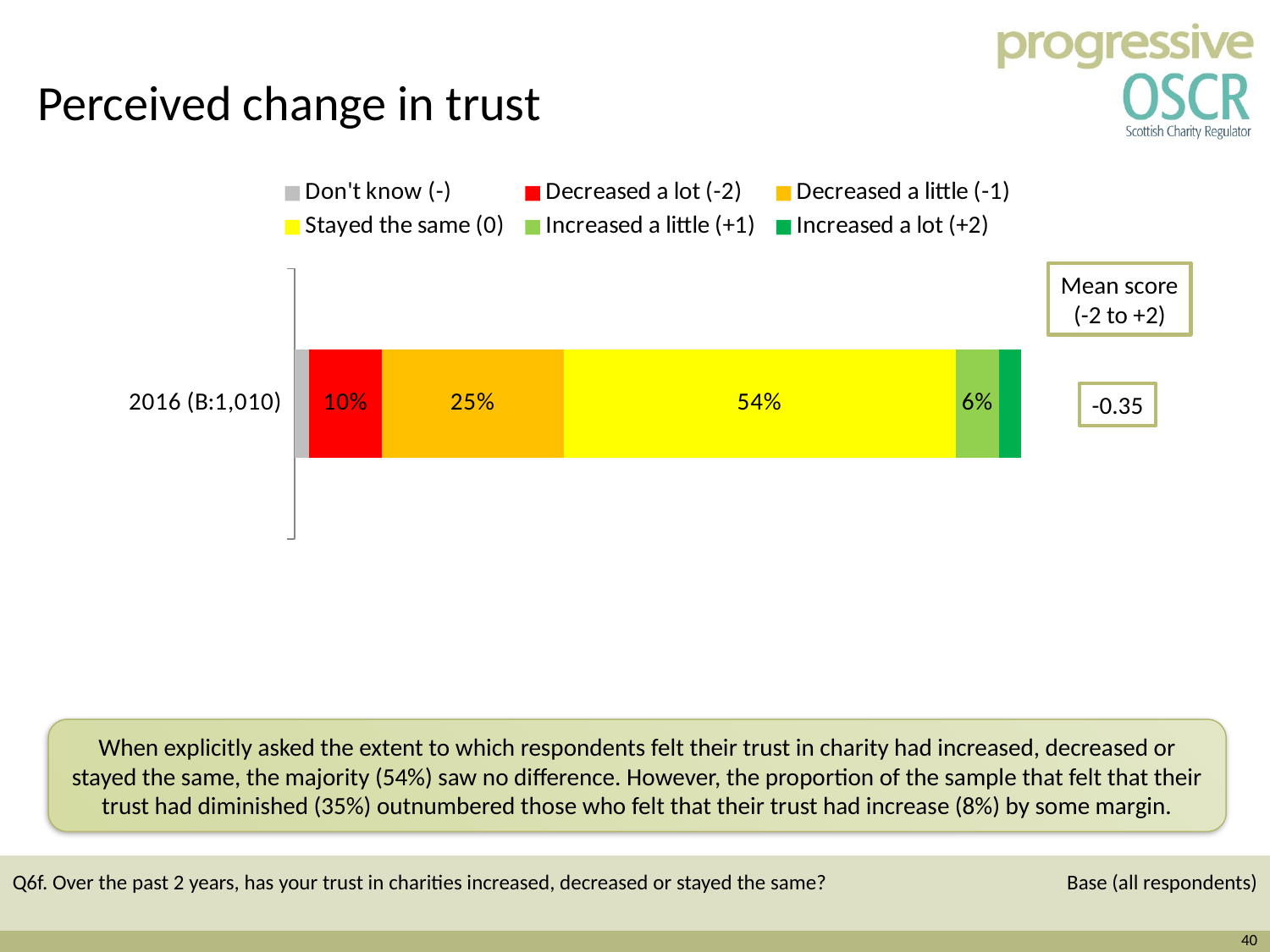
What percentage of respondents said their trust increased a little? 6% How many categories (bars) are plotted on the chart? 1 What kind of chart is shown on the slide? Stacked bar chart What percentage of respondents said their trust decreased a little? 25% What percentage of respondents said their trust decreased a lot? 10% What is the difference in percentage points between 'Stayed the same' and 'Decreased a little'? 29 percentage points How many series does the legend list? 6 What is the difference in percentage points between 'Decreased a little' and 'Decreased a lot'? 15 percentage points Which is larger: the share who said trust decreased a lot or the share who said it increased a little? Decreased a lot What mean score (-2 to +2) is shown next to the bar? -0.35 What percentage of respondents said their trust in charities stayed the same? 54% Which response category makes up the largest segment of the bar? Stayed the same (0)